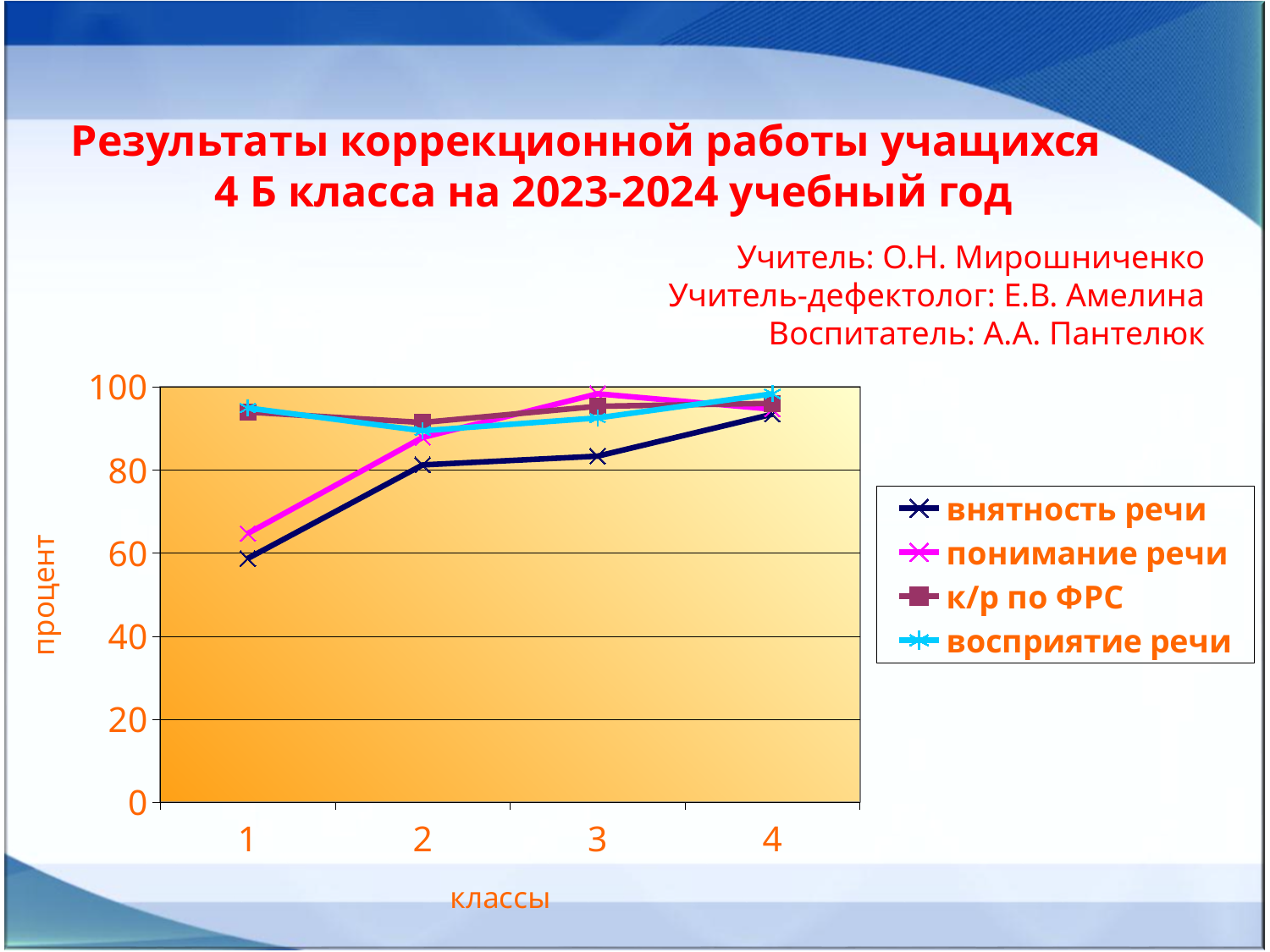
What is the label of the horizontal axis? классы How many series does the legend list? 4 Is the value for к/р по ФРС at class 1 greater or less than 80? greater How many classes (points) are shown along the x axis? 4 Is the value for внятность речи at class 1 greater or less than 80? less What is the label of the vertical axis? процент Is the value for внятность речи at class 4 greater or less than 80? greater At class 1, which is higher: внятность речи or восприятие речи? восприятие речи What kind of chart is shown on the slide? line chart Does the value for внятность речи rise or fall from class 1 to class 4? rise Which series has the lowest value at class 1? внятность речи